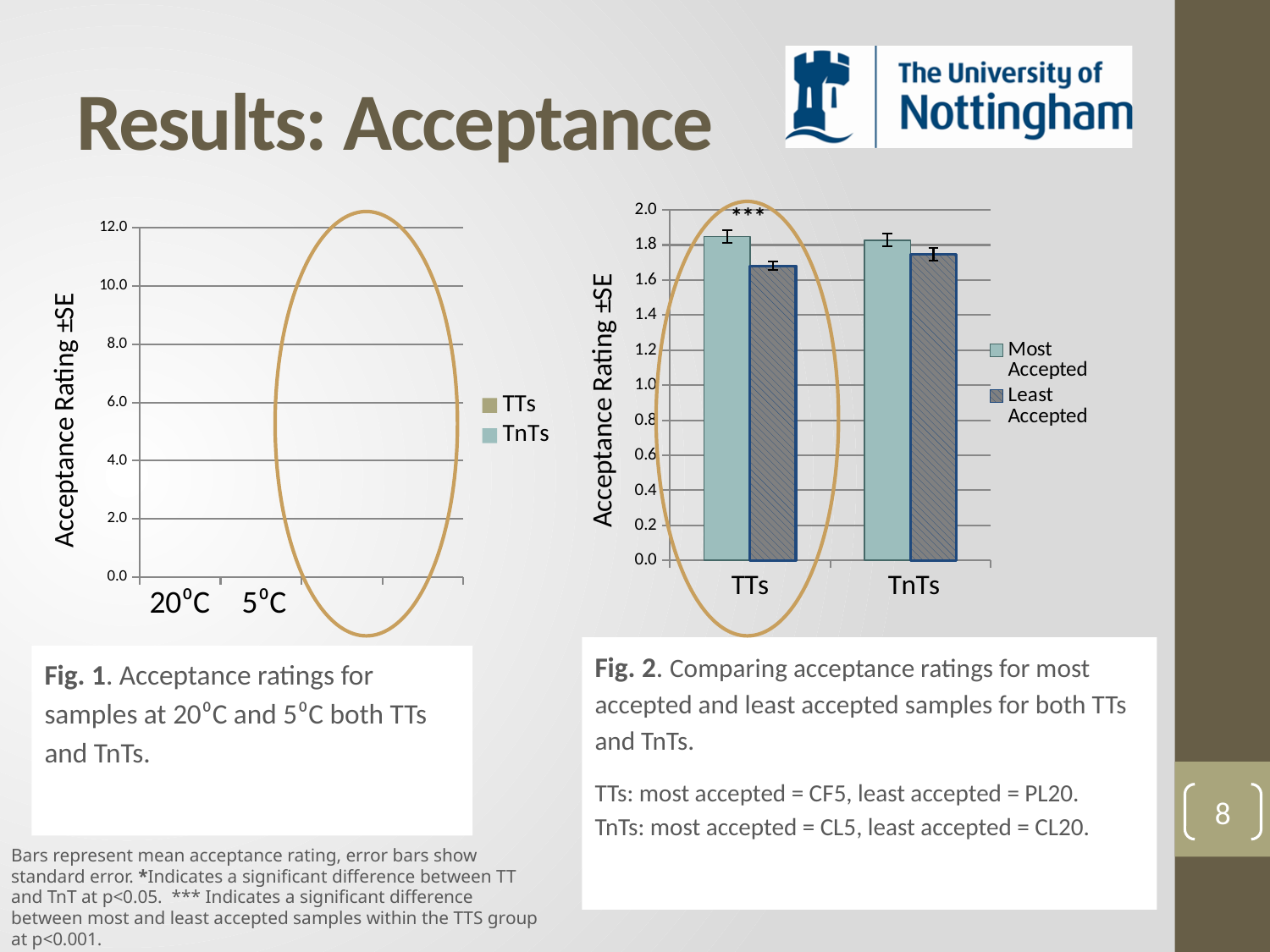
In Fig. 1 (the left chart), how many series does the legend list? 2 In Fig. 2 (the right chart), how many series does the legend list? 2 In Fig. 2 (the right chart), is the Most Accepted value for TTs greater or less than 1.8? greater In Fig. 2 (the right chart), is the Least Accepted value for TTs greater or less than 1.6? greater In Fig. 2 (the right chart), which bar is the lowest? Least Accepted for TTs In Fig. 2 (the right chart), is the Least Accepted value for TTs greater or less than 1.8? less In Fig. 2 (the right chart), how many categories are shown on the x axis? 2 In Fig. 1 (the left chart), what are the two legend entries? TTs and TnTs In Fig. 2 (the right chart), what kind of chart is shown? bar chart In Fig. 2 (the right chart), which category is marked with *** above its bars? TTs In Fig. 2 (the right chart), for TTs, which is larger: Most Accepted or Least Accepted? Most Accepted